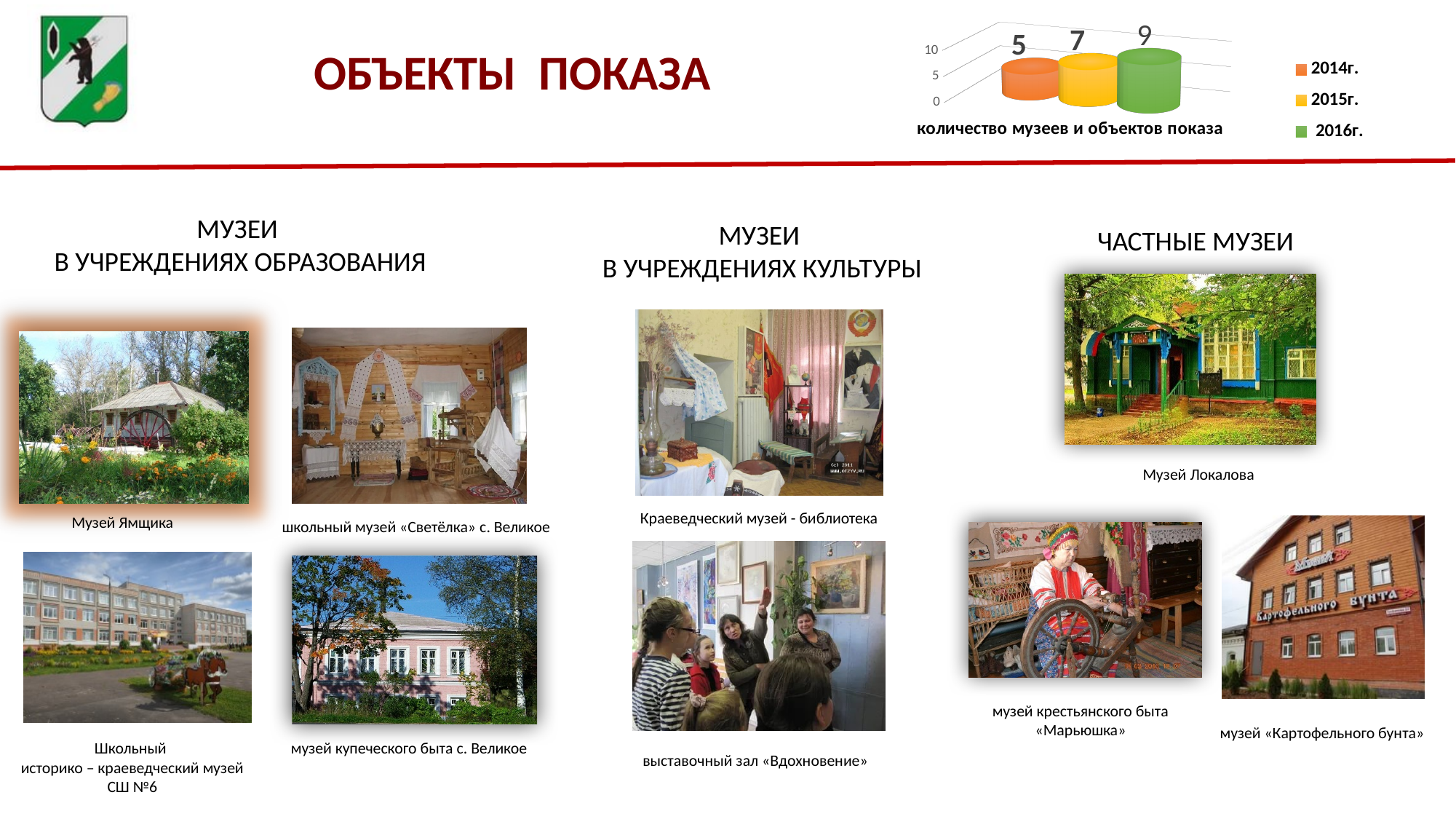
What is the difference between the values for 2016г. and 2014г.? 4 What is the value for 2015г. in the chart? 7 What is the value for 2014г. in the chart? 5 Which is larger, the value for 2015г. or the value for 2016г.? 2016г. What is the value for 2016г. in the chart? 9 Which year has the highest value in the chart? 2016г. Which year has the lowest value in the chart? 2014г. What is the difference between the values for 2015г. and 2014г.? 2 What kind of chart is shown on the slide? bar chart Do the values rise or fall from 2014г. to 2016г.? rise How many series does the legend list? 3 Is the value for 2016г. greater or less than 5? greater